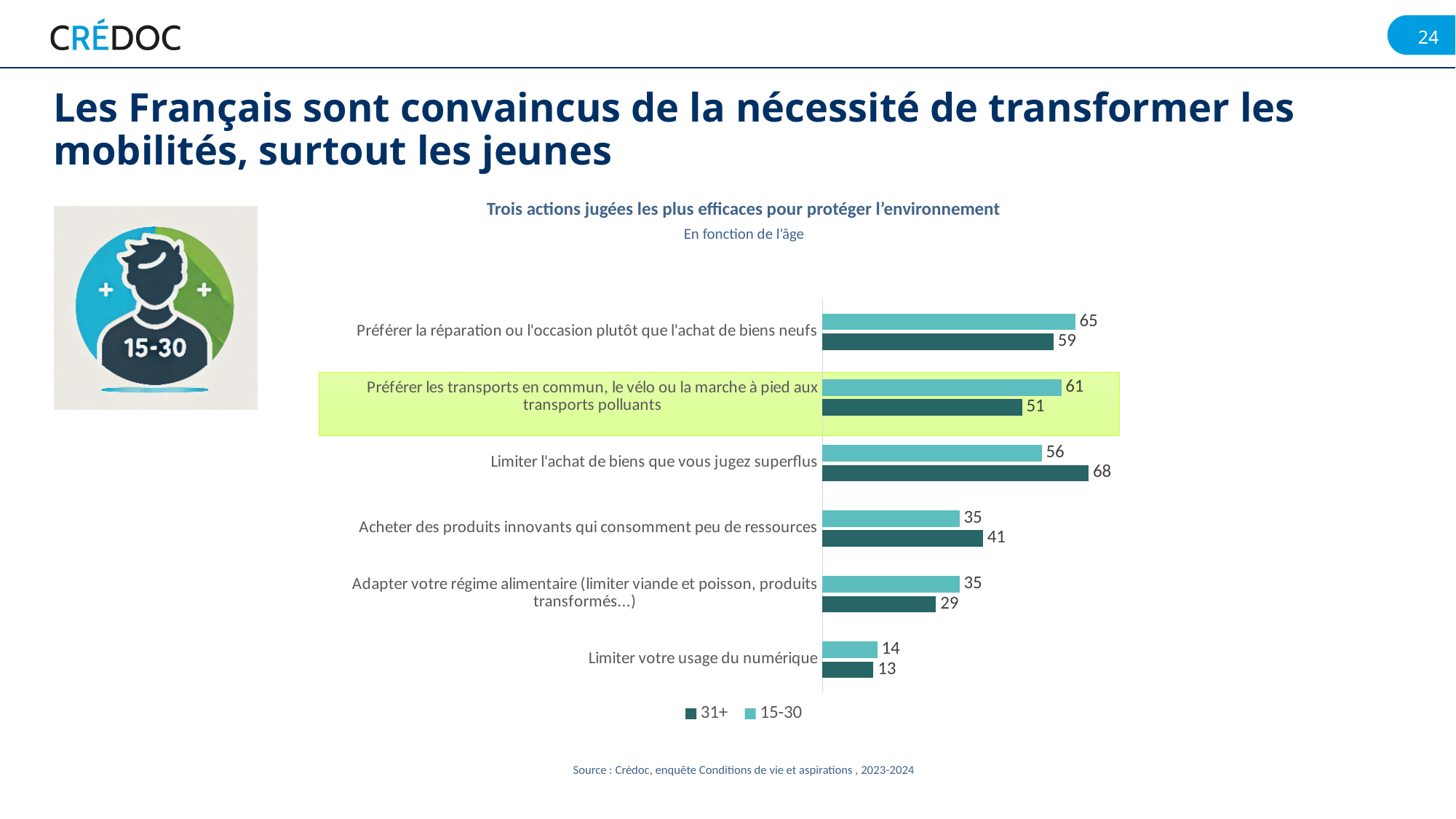
How many actions are listed in the chart? 6 What is the title of the chart? Trois actions jugées les plus efficaces pour protéger l'environnement What is the value for the 31+ age group for "Limiter l'achat de biens que vous jugez superflus"? 68 What is the value for the 31+ age group for "Préférer les transports en commun, le vélo ou la marche à pied aux transports polluants"? 51 For "Limiter l'achat de biens que vous jugez superflus", which age group has the larger value? 31+ What is the difference between the 15-30 and 31+ values for "Préférer les transports en commun, le vélo ou la marche à pied aux transports polluants"? 10 For "Adapter votre régime alimentaire", which age group has the larger value? 15-30 Which action has the lowest value for the 31+ age group? Limiter votre usage du numérique What is the value for the 15-30 age group for "Préférer la réparation ou l'occasion plutôt que l'achat de biens neufs"? 65 Which action has the highest value for the 15-30 age group? Préférer la réparation ou l'occasion plutôt que l'achat de biens neufs How many series does the legend list? 2 What kind of chart is shown on the slide? Bar chart